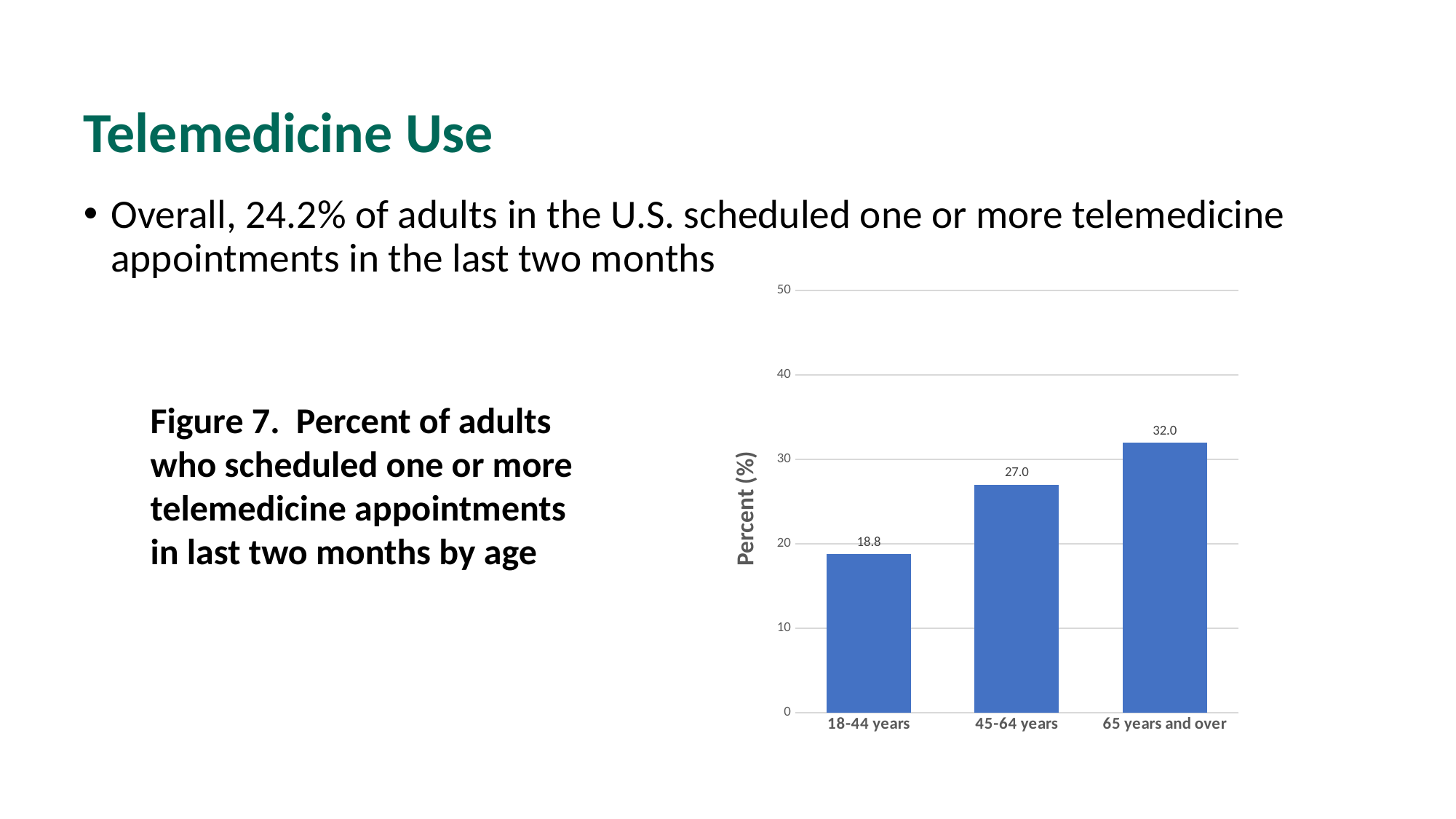
What is the value for 65 years and over? 32.0 Is the value for 65 years and over greater or less than 30? greater What is the difference between the values for 65 years and over and 18-44 years? 13.2 What is the difference between the values for 45-64 years and 18-44 years? 8.2 What is the value for 18-44 years? 18.8 Do the values rise or fall from the youngest to the oldest age group? rise What is the value for 45-64 years? 27.0 How many age groups are shown in the chart? 3 Which age group has the highest percent? 65 years and over Which age group has the lowest percent? 18-44 years What kind of chart is shown on the slide? bar chart Which is larger, the value for 45-64 years or the value for 18-44 years? 45-64 years